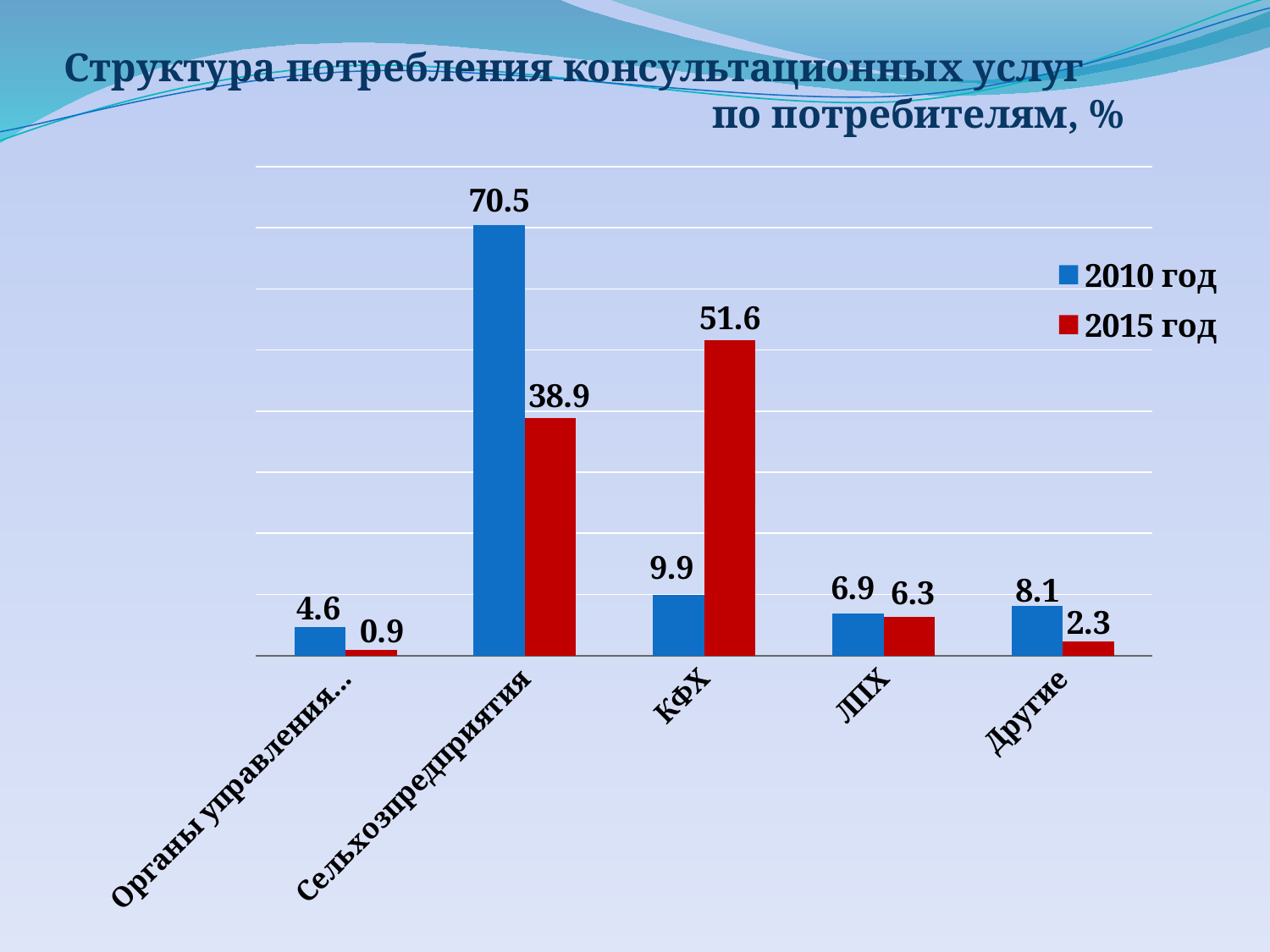
What is the value for КФХ in the 2015 год series? 51.6 Which category has the highest value in the 2015 год series? КФХ Which category has the highest value in the 2010 год series? Сельхозпредприятия What is the difference between the 2010 год and 2015 год values for Сельхозпредприятия? 31.6 What is the value for Сельхозпредприятия in the 2010 год series? 70.5 What is the value for Другие in the 2015 год series? 2.3 What is the value for ЛПХ in the 2010 год series? 6.9 Which is larger for КФХ: the 2010 год value or the 2015 год value? 2015 год Which category has the lowest value in the 2015 год series? Органы управления... What kind of chart is shown on the slide? Bar chart How many categories are shown on the x axis? 5 How many series does the legend list? 2